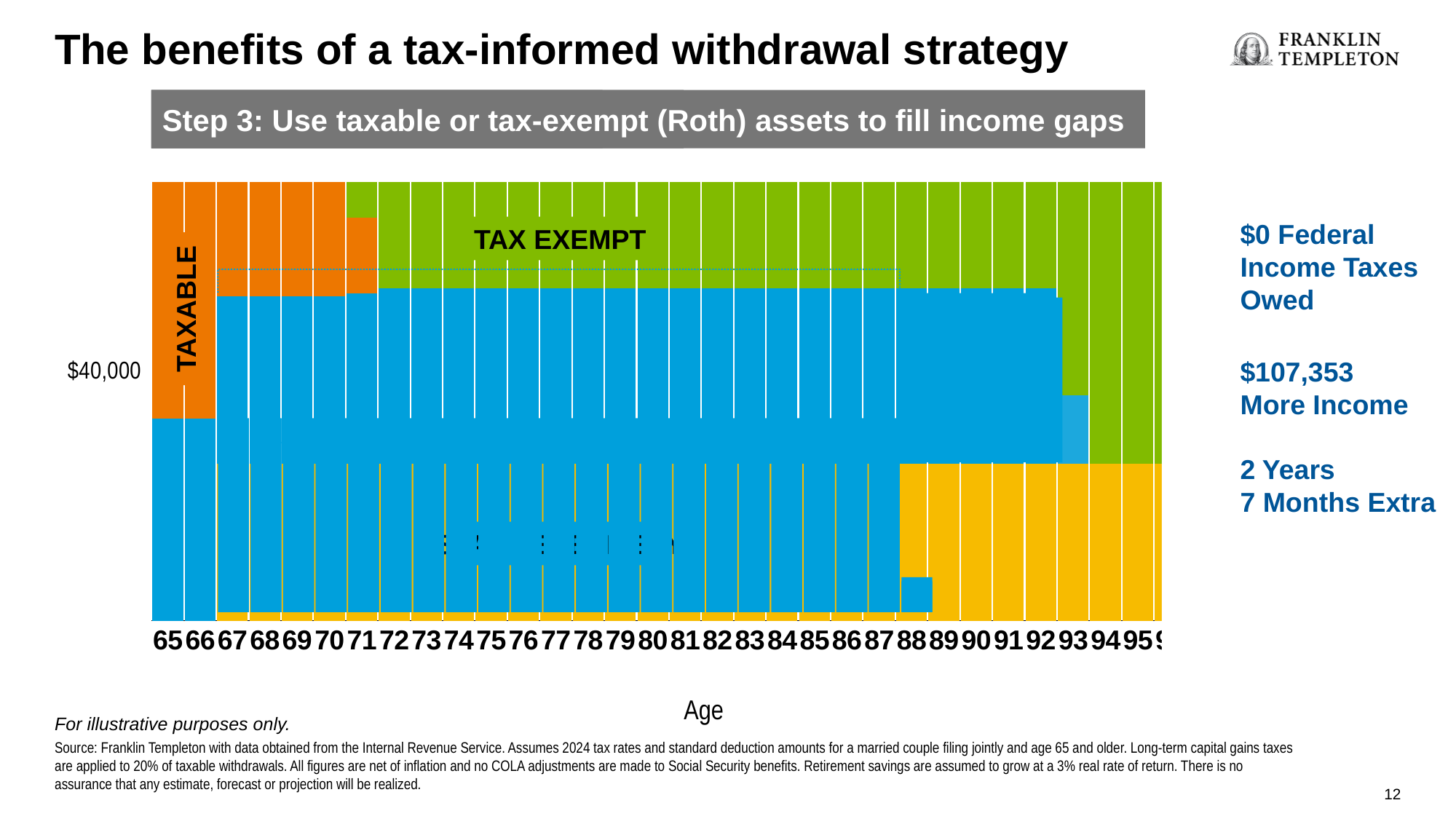
Which is larger, the blue segment for age 65 or the blue segment for age 67? Age 67 Which is larger, the orange (taxable) segment for age 65 or the orange segment for age 71? Age 65 Is the blue segment for age 65 greater or less than $40,000? less What is the first age shown on the x axis of the chart? 65 Is the total height of the bar for age 65 greater or less than $40,000? greater What label is printed on the orange segments of the chart? TAXABLE What kind of chart is shown on the slide? Bar chart What is the label of the x axis of the chart? Age Is the blue segment for age 67 greater or less than $40,000? greater What is the only value printed on the y axis of the chart? $40,000